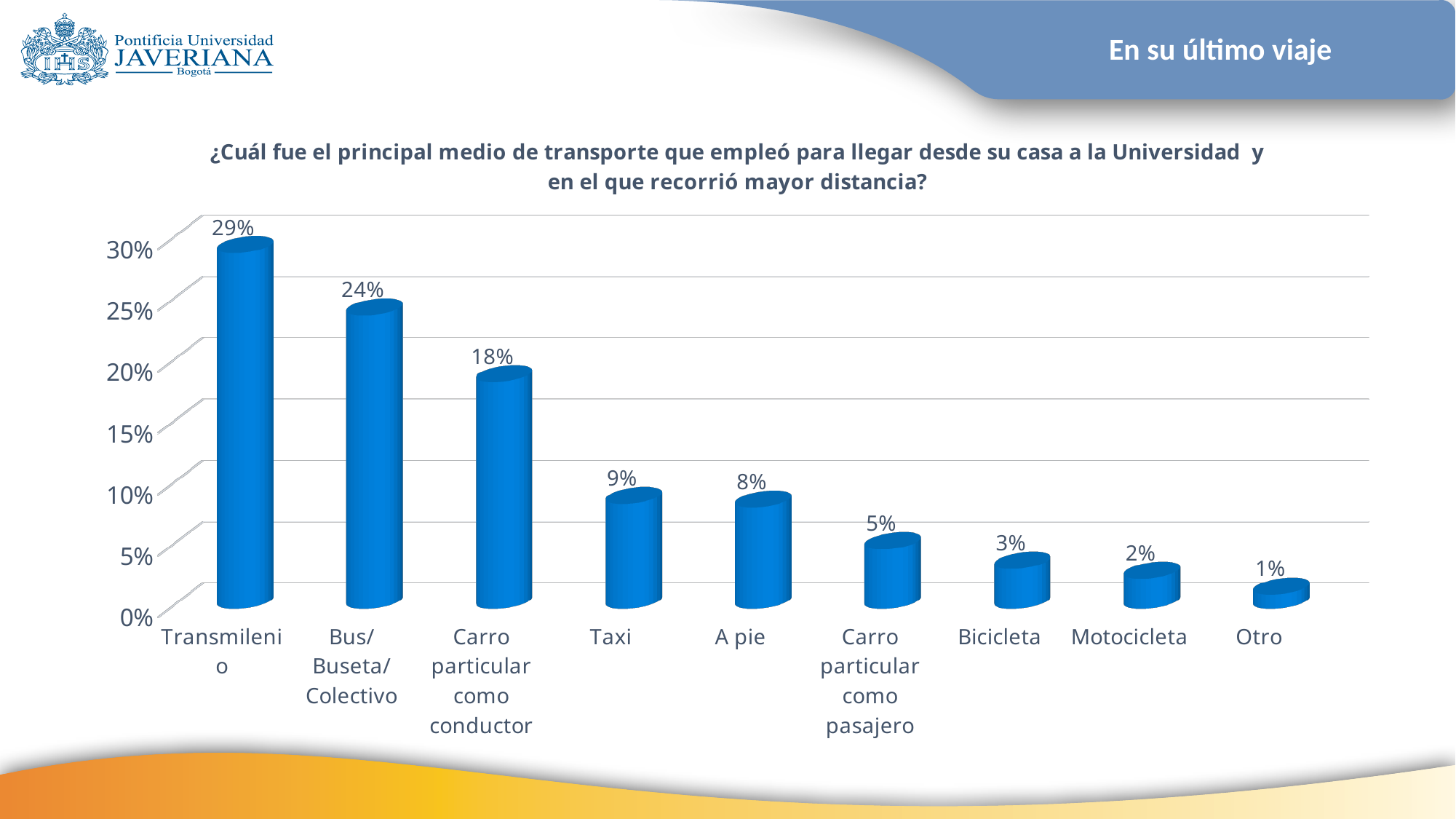
Which means of transport has the lowest percentage? Otro What is the value shown for Bicicleta? 3% Do the values rise or fall moving from left to right along the x axis? Fall What is the difference in percentage points between Transmilenio and Bus/Buseta/Colectivo? 5 What is the value shown for Taxi? 9% What percentage of respondents used Transmilenio as their main means of transport? 29% Is the value for Carro particular como conductor greater or less than 20%? less Which is larger, the value for Taxi or the value for A pie? Taxi What kind of chart is shown on the slide? Bar chart Which means of transport has the highest percentage? Transmilenio How many means of transport categories are shown on the x axis? 9 What is the difference in percentage points between Carro particular como conductor and Carro particular como pasajero? 13